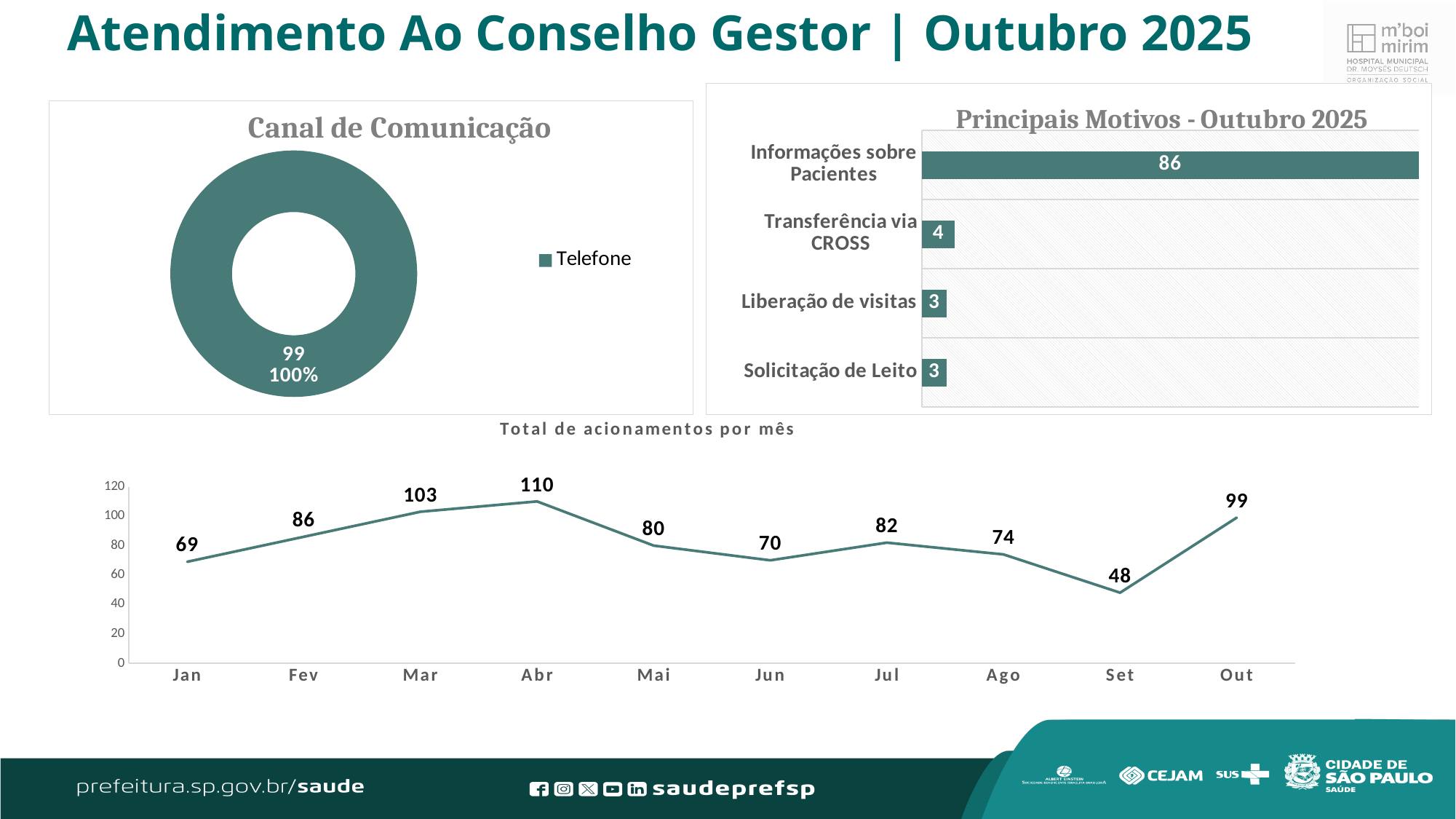
In the 'Total de acionamentos por mês' chart, how many months are plotted? 10 What kind of chart is 'Principais Motivos - Outubro 2025'? Bar chart In the 'Canal de Comunicação' chart, what share does Telefone represent? 100% In the 'Canal de Comunicação' chart, what value is shown for Telefone? 99 In the 'Principais Motivos - Outubro 2025' chart, how many categories are shown? 4 In the 'Total de acionamentos por mês' chart, what is the value for Abr? 110 In the 'Principais Motivos - Outubro 2025' chart, which category has the highest value? Informações sobre Pacientes In the 'Total de acionamentos por mês' chart, which month has the lowest value? Set In the 'Total de acionamentos por mês' chart, what is the difference between Out and Set? 51 In the 'Principais Motivos - Outubro 2025' chart, what is the value for Informações sobre Pacientes? 86 In the 'Principais Motivos - Outubro 2025' chart, what is the difference between Informações sobre Pacientes and Transferência via CROSS? 82 In the 'Total de acionamentos por mês' chart, which is larger, Mar or Jul? Mar